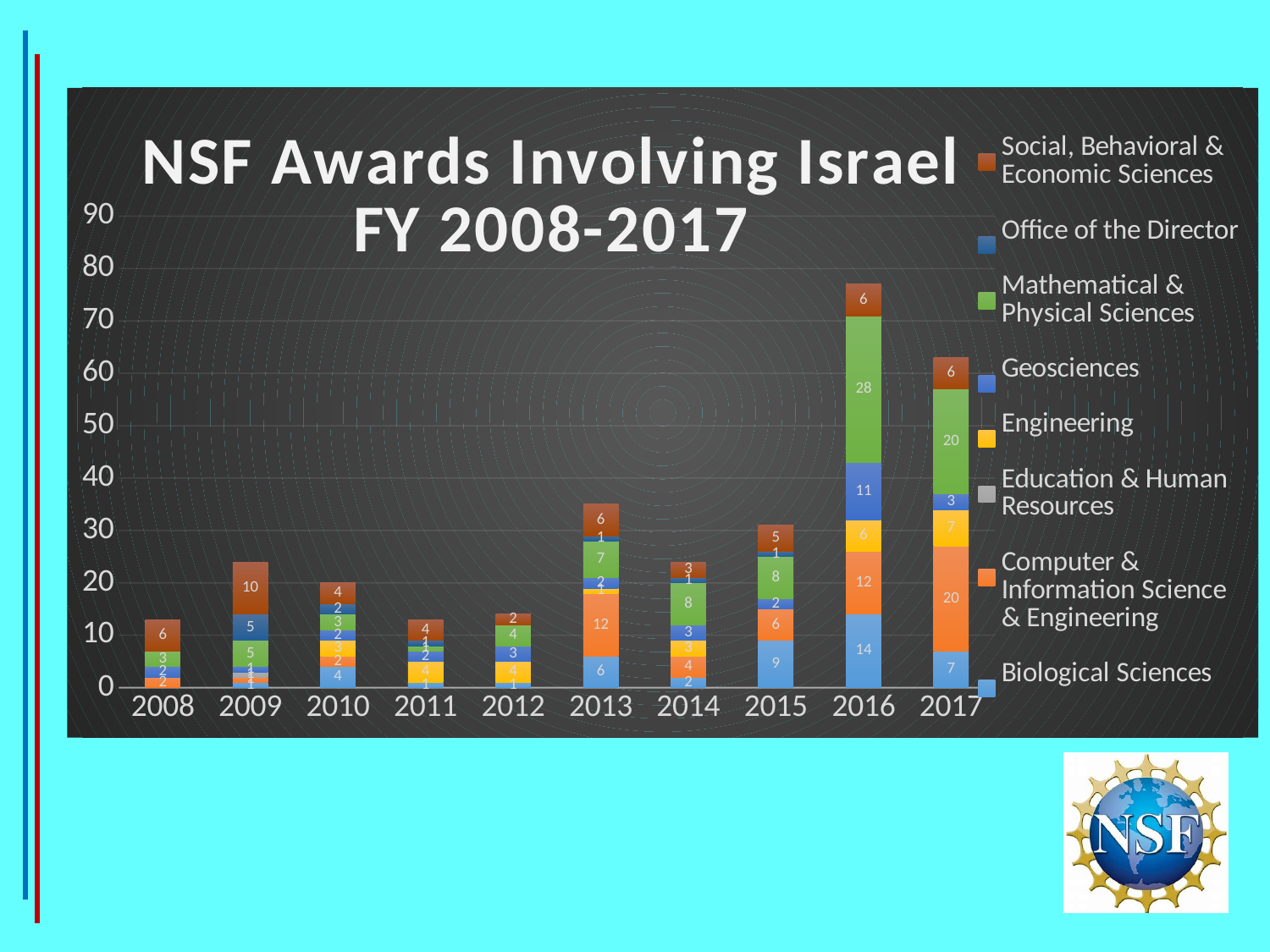
How many Computer & Information Science & Engineering awards are shown for 2017? 20 How many Mathematical & Physical Sciences awards are shown for 2016? 28 What is the title of the chart? NSF Awards Involving Israel FY 2008-2017 Which year has more Biological Sciences awards, 2015 or 2016? 2016 What is the total number of awards in the 2016 bar? 77 What is the difference between the Mathematical & Physical Sciences awards in 2016 and in 2017? 8 How many fiscal years are shown on the x axis? 10 How many Biological Sciences awards are shown for 2016? 14 How many series does the legend list? 8 What kind of chart is shown on the slide? Stacked bar chart How many Social, Behavioral & Economic Sciences awards are shown for 2009? 10 Which year has the highest total number of awards? 2016